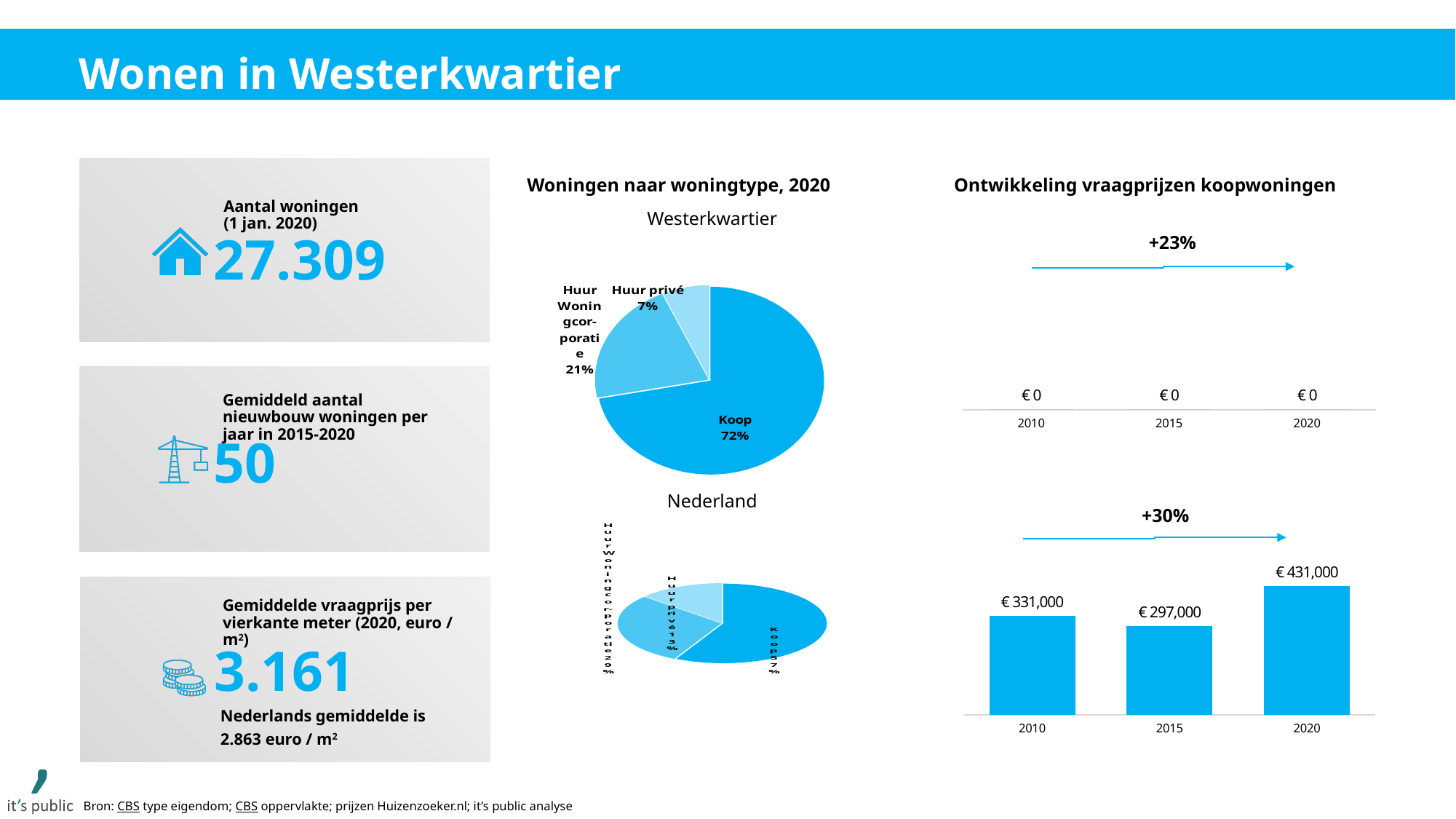
In the Westerkwartier pie chart, what is the difference in percentage points between Koop and Huur Woningcorporatie? 51 In the lower bar chart under 'Ontwikkeling vraagprijzen koopwoningen', what is the value for 2020? € 431,000 In the Westerkwartier pie chart, which category has the smallest slice? Huur privé In the Westerkwartier pie chart, what share is labelled for Huur Woningcorporatie? 21% What kind of chart is used to show 'Woningen naar woningtype, 2020' for Westerkwartier? pie chart In the Westerkwartier pie chart, which category has the largest slice? Koop In the lower bar chart under 'Ontwikkeling vraagprijzen koopwoningen', which year has the lowest value? 2015 In the Westerkwartier pie chart, how many slices are there? 3 In the Westerkwartier pie chart under 'Woningen naar woningtype, 2020', what share is labelled for Koop? 72% In the lower bar chart under 'Ontwikkeling vraagprijzen koopwoningen', what is the difference between the 2020 and 2010 values? € 100,000 In the Westerkwartier pie chart, what share is labelled for Huur privé? 7% In the lower bar chart under 'Ontwikkeling vraagprijzen koopwoningen', what is the value for 2015? € 297,000